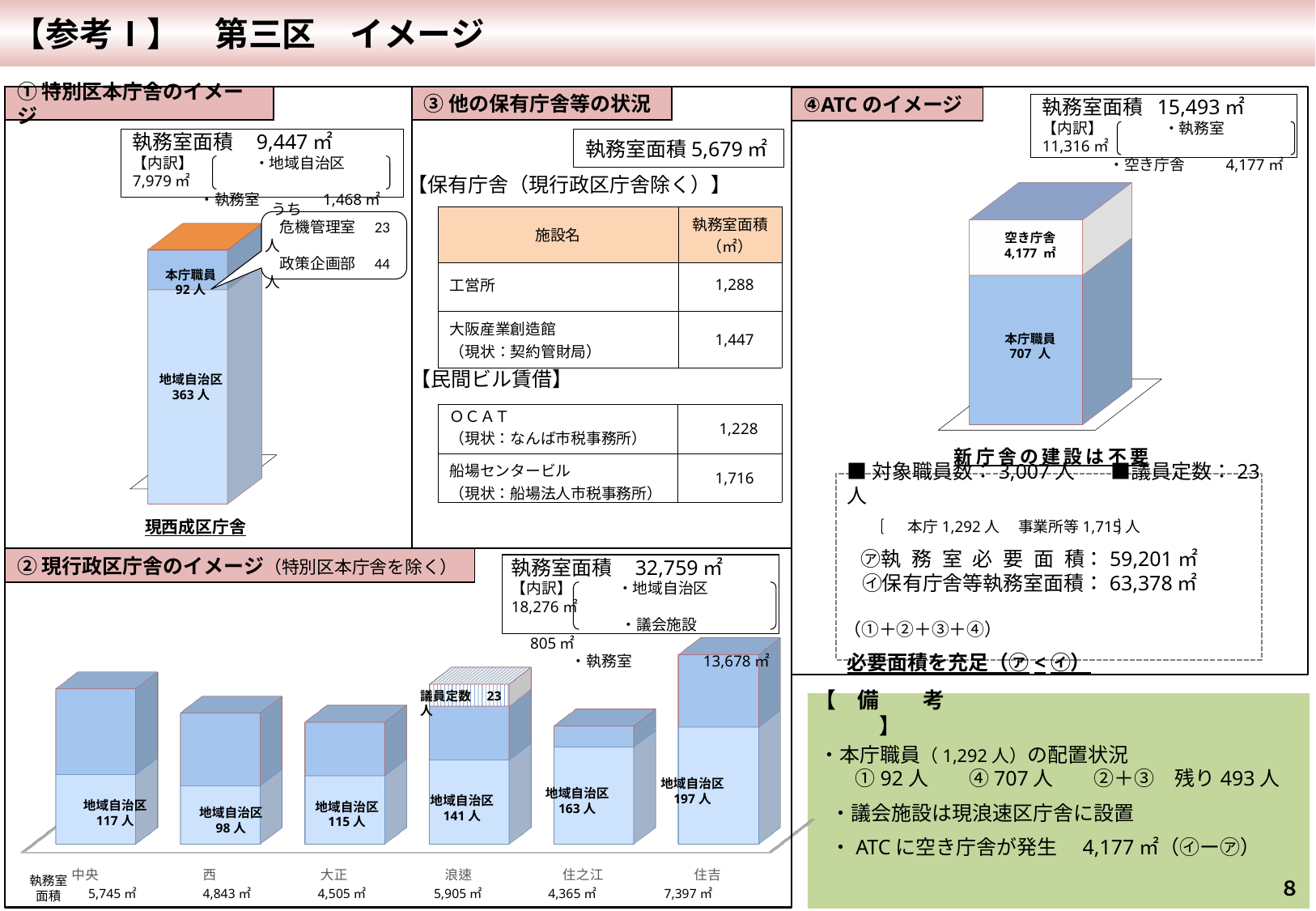
In the ② 現行政区庁舎のイメージ diagram, which ward has the lowest 地域自治区 staff count? 西 In the ③ 他の保有庁舎等の状況 table, what is the 執務室面積 of 船場センタービル? 1,716 In the ① 特別区本庁舎のイメージ diagram, how many 本庁職員 are shown? 92 人 In the ② 現行政区庁舎のイメージ diagram, how many 地域自治区 staff are shown for 住吉? 197 人 In the ② 現行政区庁舎のイメージ diagram, which ward's block carries the 議員定数 23 人 label? 浪速 In the ② 現行政区庁舎のイメージ diagram, which ward has the highest 地域自治区 staff count? 住吉 In the ② 現行政区庁舎のイメージ diagram, what is the difference in 地域自治区 staff between 住吉 and 西? 99 人 In the ② 現行政区庁舎のイメージ diagram, which ward has the smallest 執務室面積? 住之江 In the ④ ATC のイメージ diagram, what is the area of the 空き庁舎 block? 4,177 ㎡ In the ② 現行政区庁舎のイメージ diagram, which has the larger 執務室面積, 浪速 or 大正? 浪速 How many wards are shown in the ② 現行政区庁舎のイメージ diagram? 6 In the ② 現行政区庁舎のイメージ diagram, what is the 執務室面積 shown for 中央? 5,745 ㎡